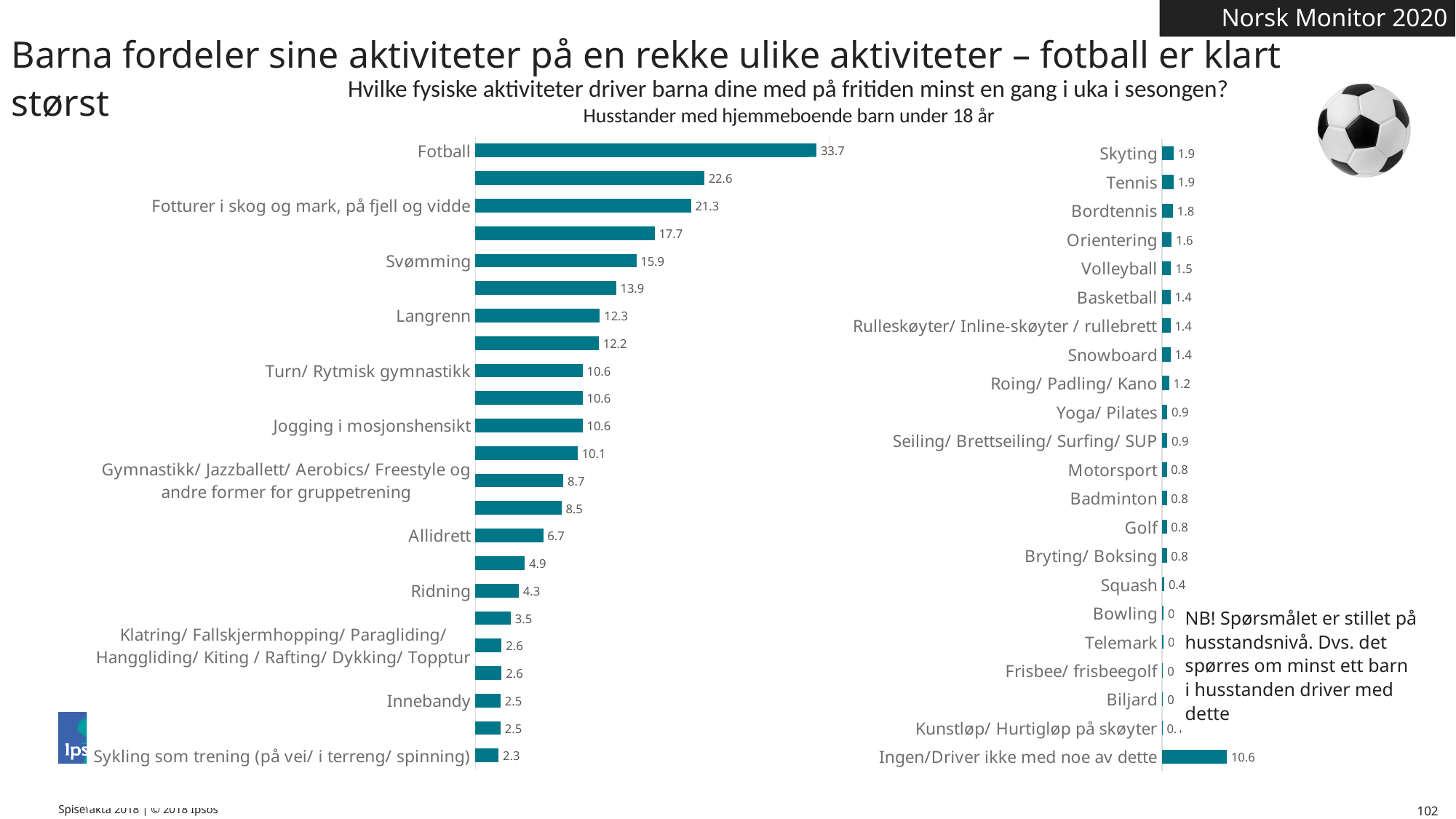
On the left chart, what is the value for Fotball? 33.7 On the left chart, what is the difference between the values for Fotball and Fotturer i skog og mark, på fjell og vidde? 12.4 On the right chart, which has a larger value, Bordtennis or Squash? Bordtennis On the right chart, what is the value for Orientering? 1.6 On the left chart, what is the value for Langrenn? 12.3 What kind of chart is used on the left side of the slide? Bar chart On the left chart, which activity has the highest value? Fotball On the left chart, what is the value for Svømming? 15.9 How many categories are shown on the right chart? 22 On the right chart, which category has the highest value? Ingen/Driver ikke med noe av dette On the left chart, which has a larger value, Allidrett or Ridning? Allidrett On the right chart, what is the value for Ingen/Driver ikke med noe av dette? 10.6